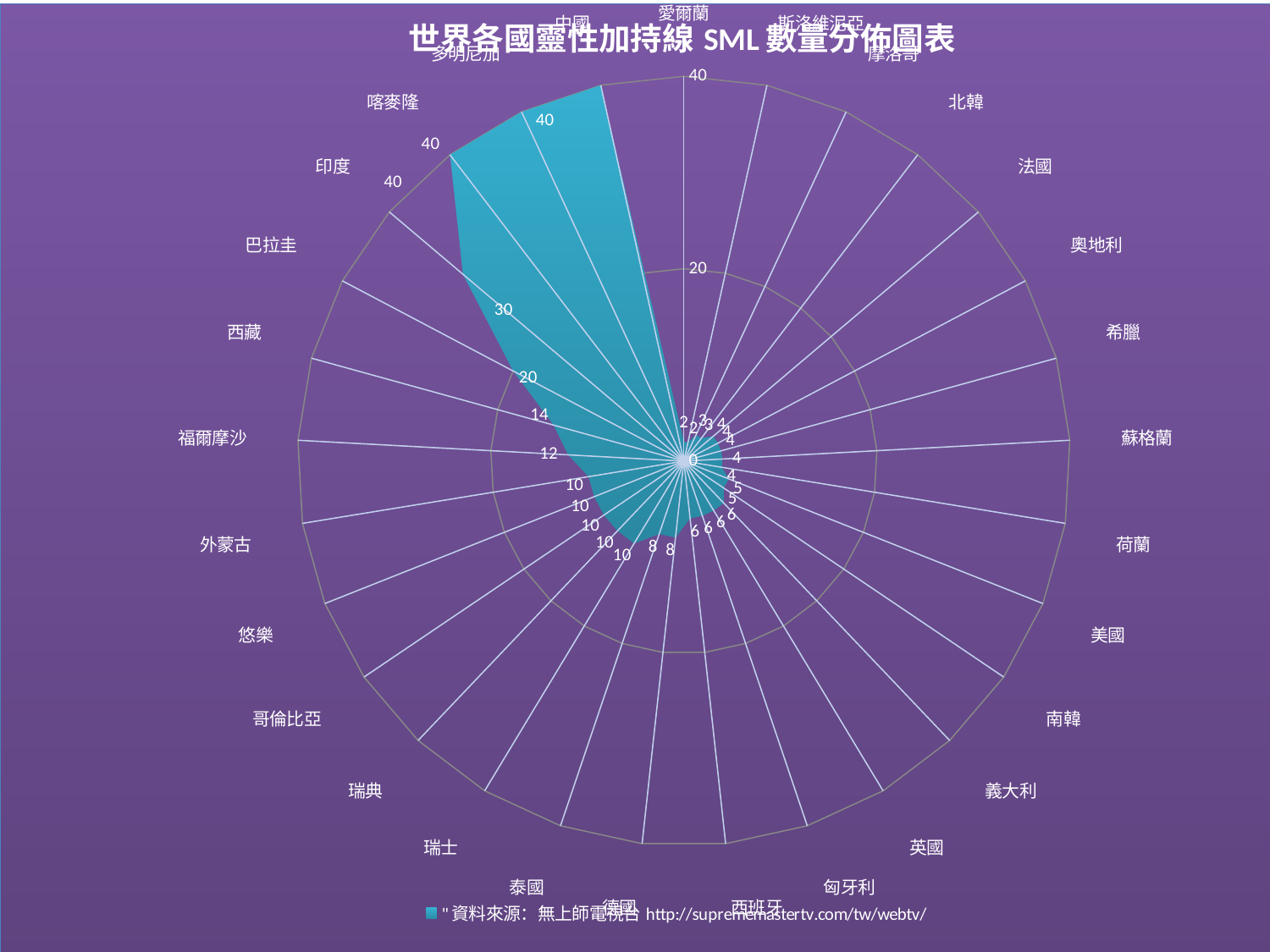
What is the value for 巴拉圭? 20 What is the difference between the values for 印度 and 巴拉圭? 10 Is the value for 西藏 greater or less than 20? less Which has the larger value, 印度 or 巴拉圭? 印度 What is the value for 印度? 30 What is the title of the chart? 世界各國靈性加持線 SML 數量分佈圖表 What is the value for 西藏? 14 What is the value for 福爾摩沙? 12 How many series does the legend list? 1 What kind of chart is shown on the slide? Radar chart How many countries/regions are plotted around the radar chart? 29 What is the value for 喀麥隆? 40